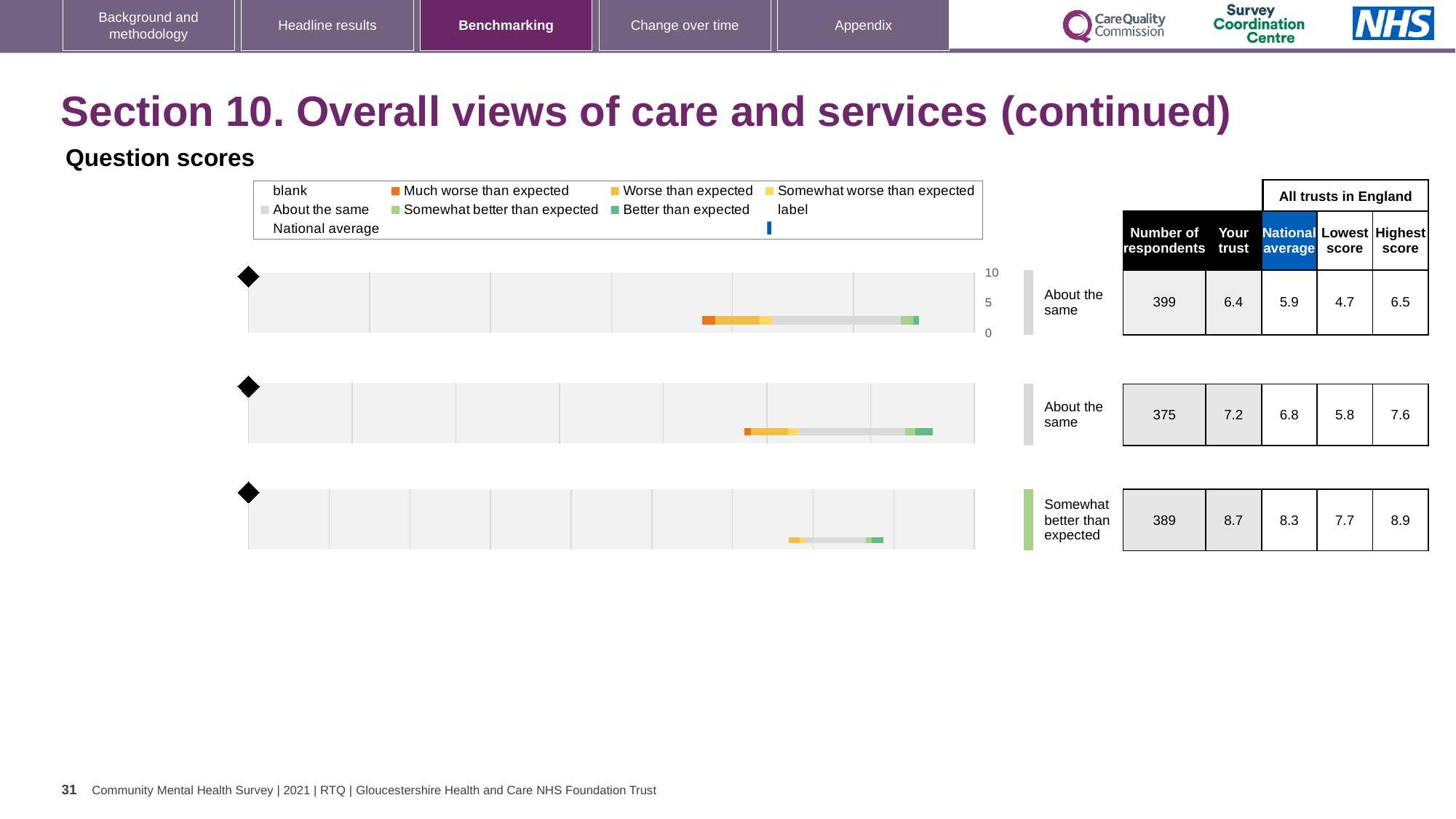
How many question score charts are shown on the slide? 3 For the middle chart, what is the national average score? 6.8 In the legend, which category is shown in orange? Much worse than expected Which of the three charts has the highest 'Your trust' score? the bottom chart Which has the higher 'Your trust' score, the middle chart or the bottom chart? the bottom chart For the top chart, what is the difference between the 'Your trust' score and the national average? 0.5 For the bottom chart, how many respondents are there? 389 For the top chart, what is the 'Your trust' score? 6.4 What kind of chart is used to show the question scores on this slide? bar chart What benchmark category is shown next to the bottom chart? Somewhat better than expected For the bottom chart, what is the difference between the highest score and the lowest score among all trusts in England? 1.2 Which of the three charts has the lowest 'Lowest score' value among all trusts in England? the top chart